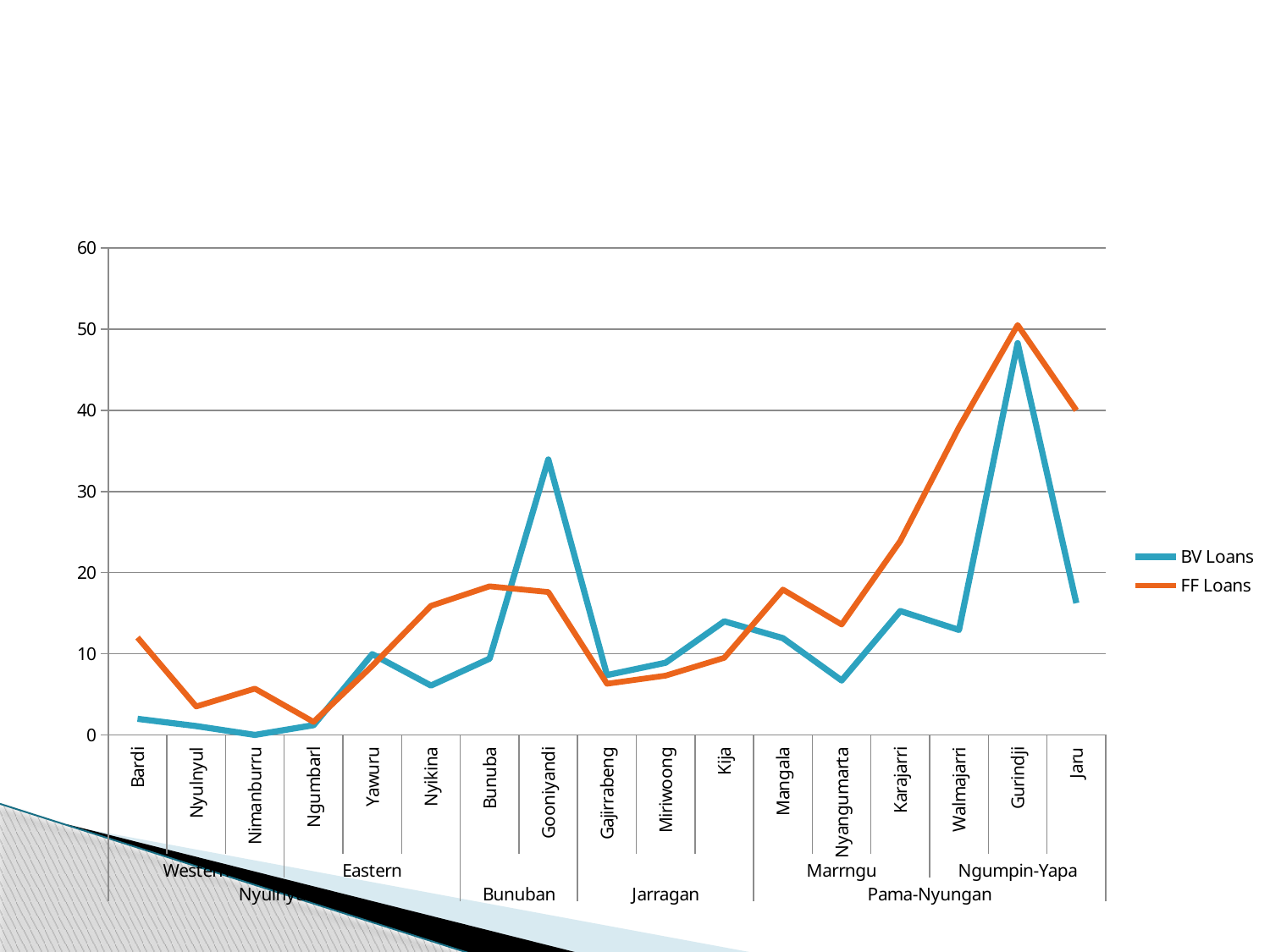
Is the FF Loans value for Jaru greater or less than 30? greater For Karajarri, which series has the larger value, BV Loans or FF Loans? FF Loans What kind of chart is shown on the slide? Line chart For Gooniyandi, which series has the larger value, BV Loans or FF Loans? BV Loans Is the BV Loans value for Nyangumarta greater or less than 10? less Which language has the lowest BV Loans value? Nimanburru How many series does the legend list? 2 What are the two series named in the legend? BV Loans and FF Loans Which language has the highest FF Loans value? Gurindji How many language categories are plotted along the x axis? 17 Which language has the highest BV Loans value? Gurindji Is the BV Loans value for Gooniyandi greater or less than 30? greater